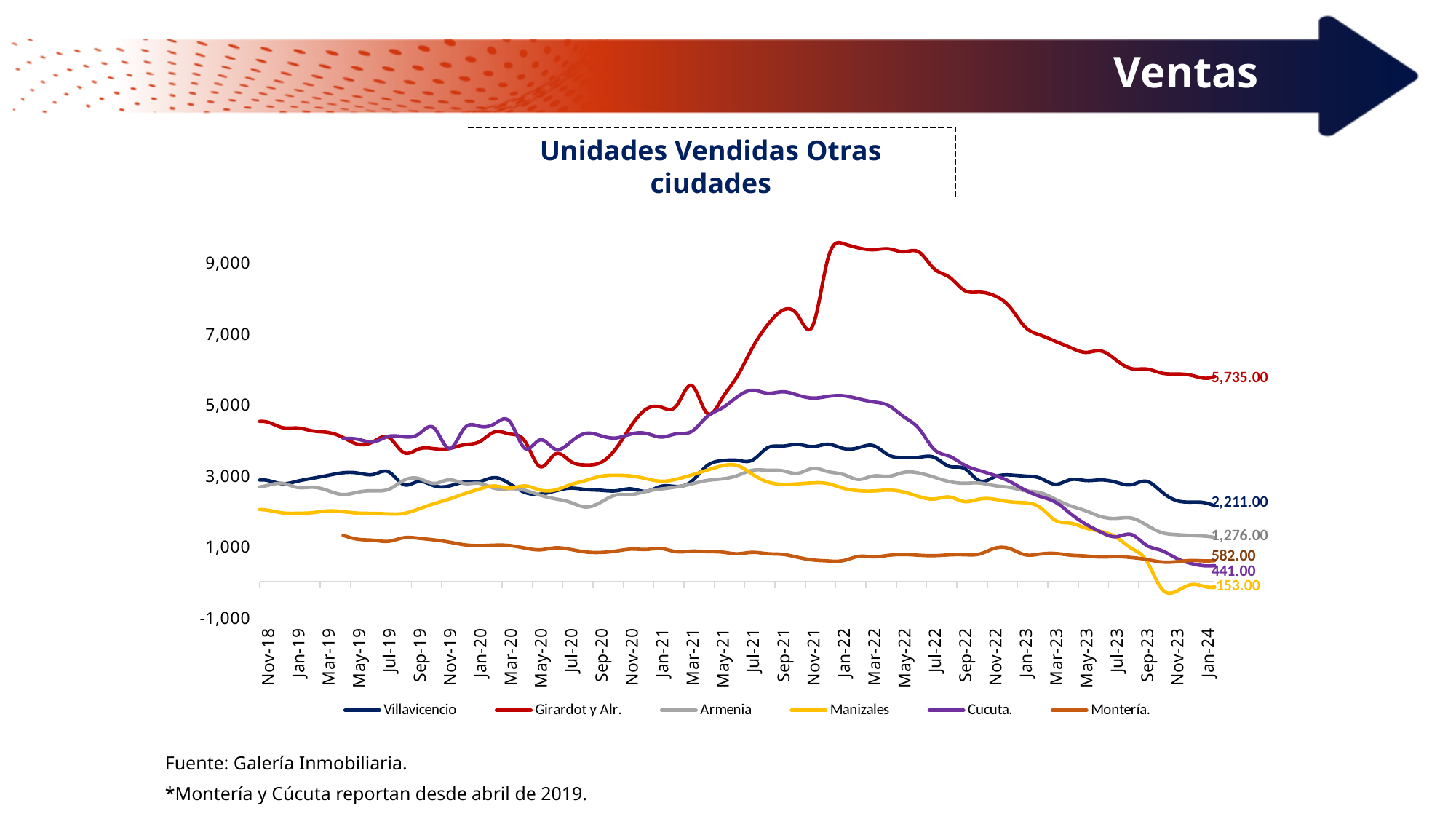
What is the final labelled value for Manizales? 153.00 What is the final labelled value for Armenia? 1,276.00 What type of chart is shown on the slide? line chart Which series has the highest final labelled value? Girardot y Alr. What is the difference between the final labelled values of Girardot y Alr. and Villavicencio? 3,524.00 Which has a larger final labelled value, Montería or Cucuta? Montería What is the final labelled value for Girardot y Alr.? 5,735.00 How many series does the legend list? 6 Which series has the lowest final labelled value? Manizales What is the title of the chart? Unidades Vendidas Otras ciudades Does the Girardot y Alr. line rise or fall between Jan-22 and Jan-24? fall What is the final labelled value for Villavicencio? 2,211.00